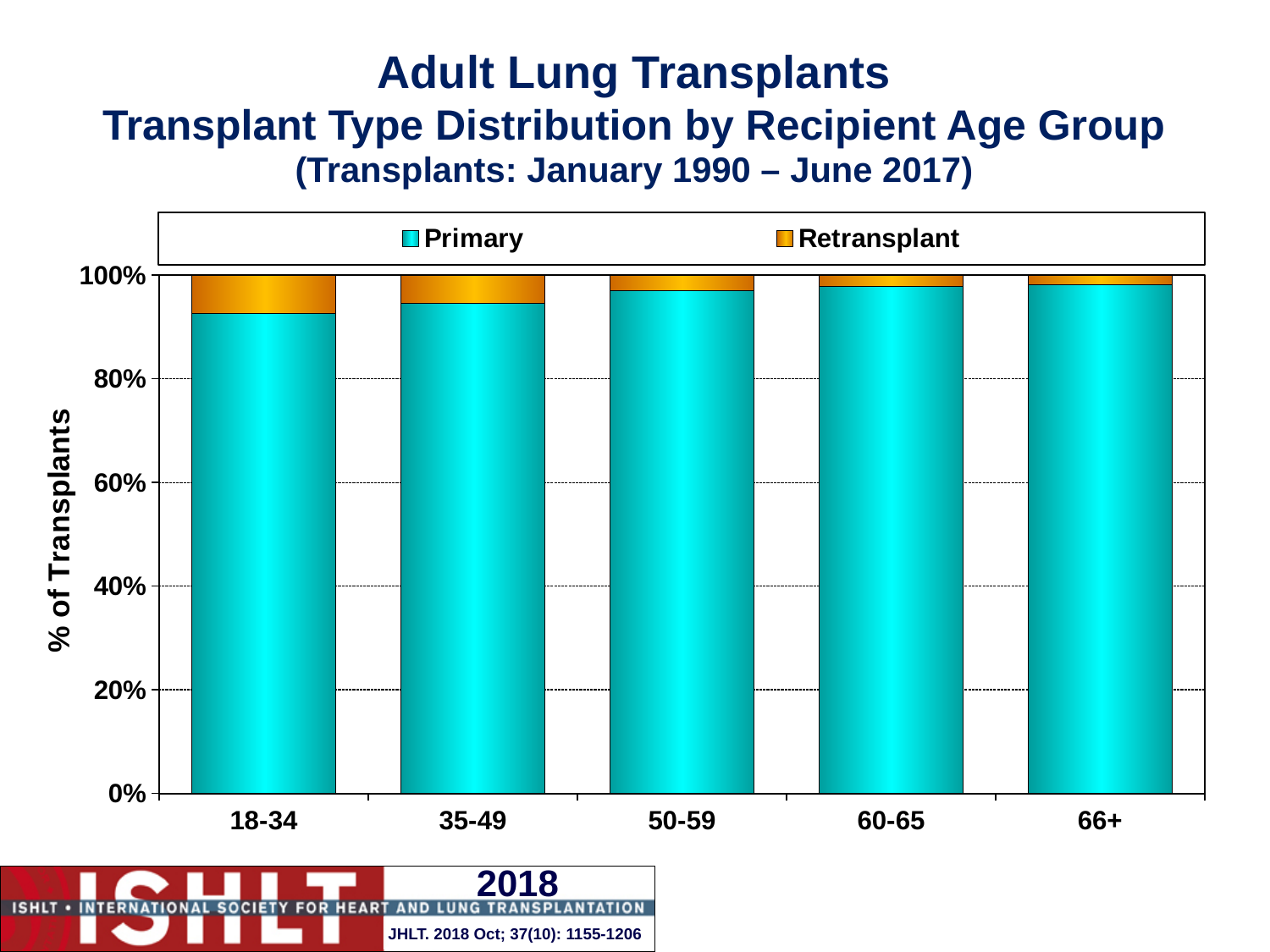
Does the Retransplant share rise or fall as recipient age group increases along the x axis? fall What is the label of the y axis? % of Transplants Which age group has the smallest Primary share? 18-34 What kind of chart is shown on the slide? Stacked bar chart Is the Primary share for the 18-34 age group greater or less than 80%? greater Is the Retransplant share for the 66+ age group greater or less than 20%? less Which two series are listed in the legend? Primary and Retransplant Which is larger, the Retransplant share for 18-34 or for 50-59? 18-34 How many recipient age groups are shown on the x axis? 5 How many series does the legend list? 2 What is the total height of each stacked bar? 100% Which age group has the largest Retransplant share? 18-34